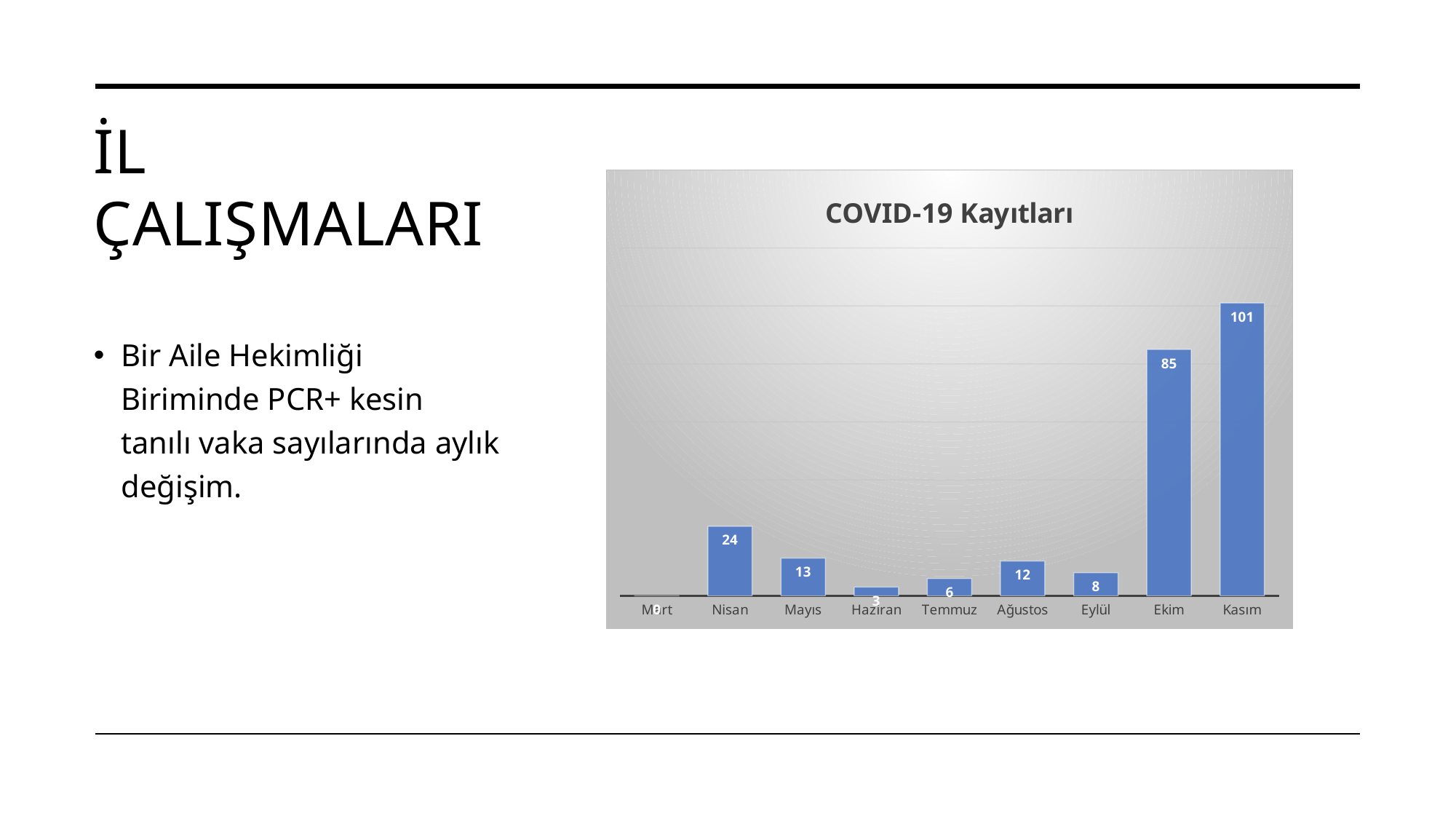
What is the difference between the values for Nisan and Mayıs in the COVID-19 Kayıtları chart? 11 Which is larger in the COVID-19 Kayıtları chart, the value for Temmuz or the value for Eylül? Eylül What is the difference between the values for Kasım and Ekim in the COVID-19 Kayıtları chart? 16 What is the value for Ağustos in the COVID-19 Kayıtları chart? 12 Which month has the highest value in the COVID-19 Kayıtları chart? Kasım What is the value for Nisan in the COVID-19 Kayıtları chart? 24 How many months are shown on the x axis of the COVID-19 Kayıtları chart? 9 What is the value for Kasım in the COVID-19 Kayıtları chart? 101 What kind of chart is the COVID-19 Kayıtları chart? Bar chart What is the value for Haziran in the COVID-19 Kayıtları chart? 3 What is the value for Ekim in the COVID-19 Kayıtları chart? 85 What is the title of the chart on the slide? COVID-19 Kayıtları